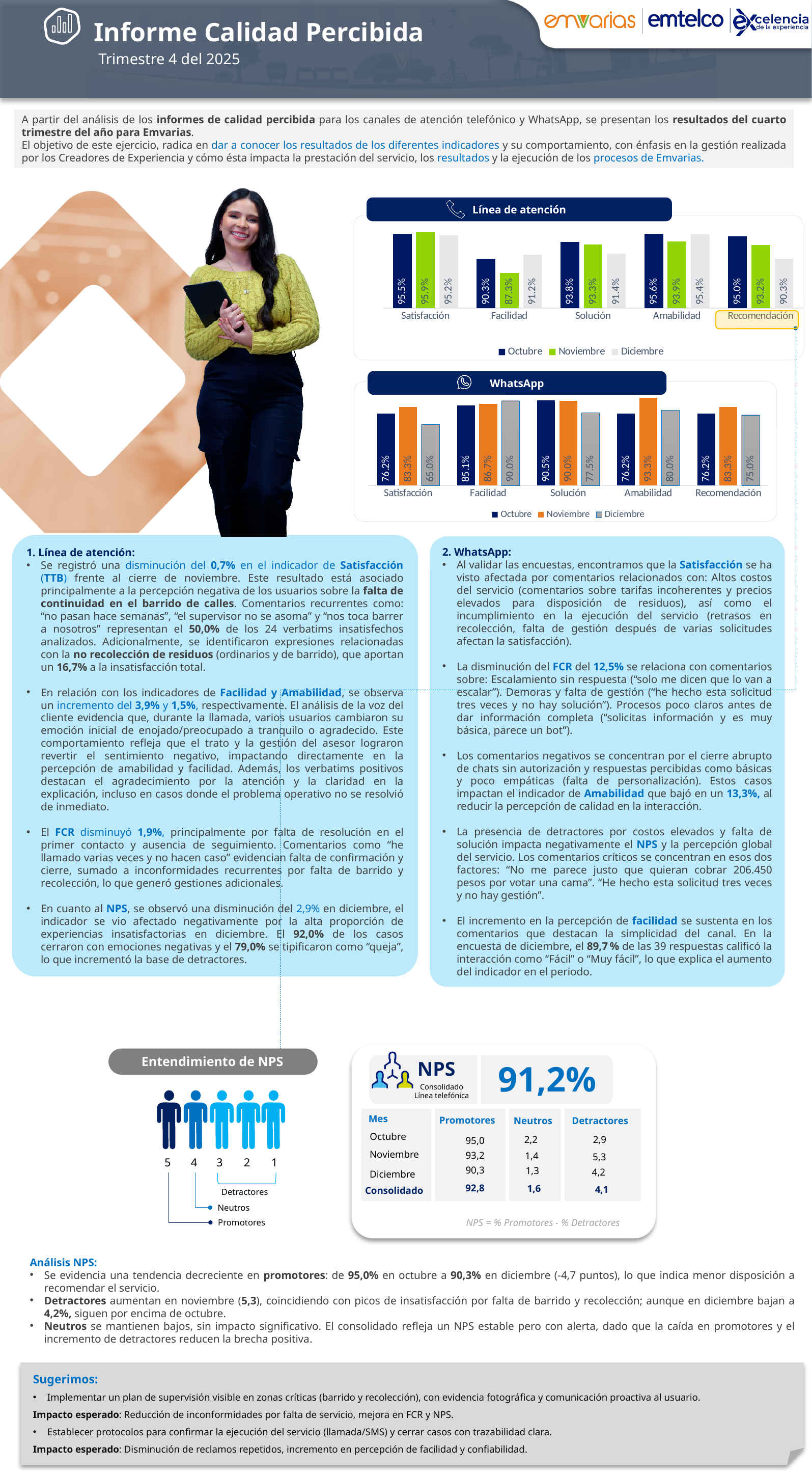
In the 'Línea de atención' chart, what is the difference between the Octubre and Diciembre values for Recomendación? 4.7% In the 'Línea de atención' chart, what is the value for Satisfacción in Noviembre? 95.9% In the 'WhatsApp' chart, is the Octubre value for Solución larger or the Diciembre value for Solución? Octubre In the 'Línea de atención' chart, how many series does the legend list? 3 In the 'WhatsApp' chart, what is the difference between the Noviembre and Octubre values for Amabilidad? 17.1% In the 'Línea de atención' chart, what is the value for Facilidad in Noviembre? 87.3% How many categories are shown on the x axis of the 'WhatsApp' chart? 5 In the 'WhatsApp' chart, what is the value for Amabilidad in Noviembre? 93.3% In the 'WhatsApp' chart, what is the value for Satisfacción in Diciembre? 65.0% In the 'Línea de atención' chart, which category has the lowest value in Diciembre? Recomendación In the 'WhatsApp' chart, which category has the highest value in Diciembre? Facilidad What kind of chart is the 'Línea de atención' chart? Bar chart